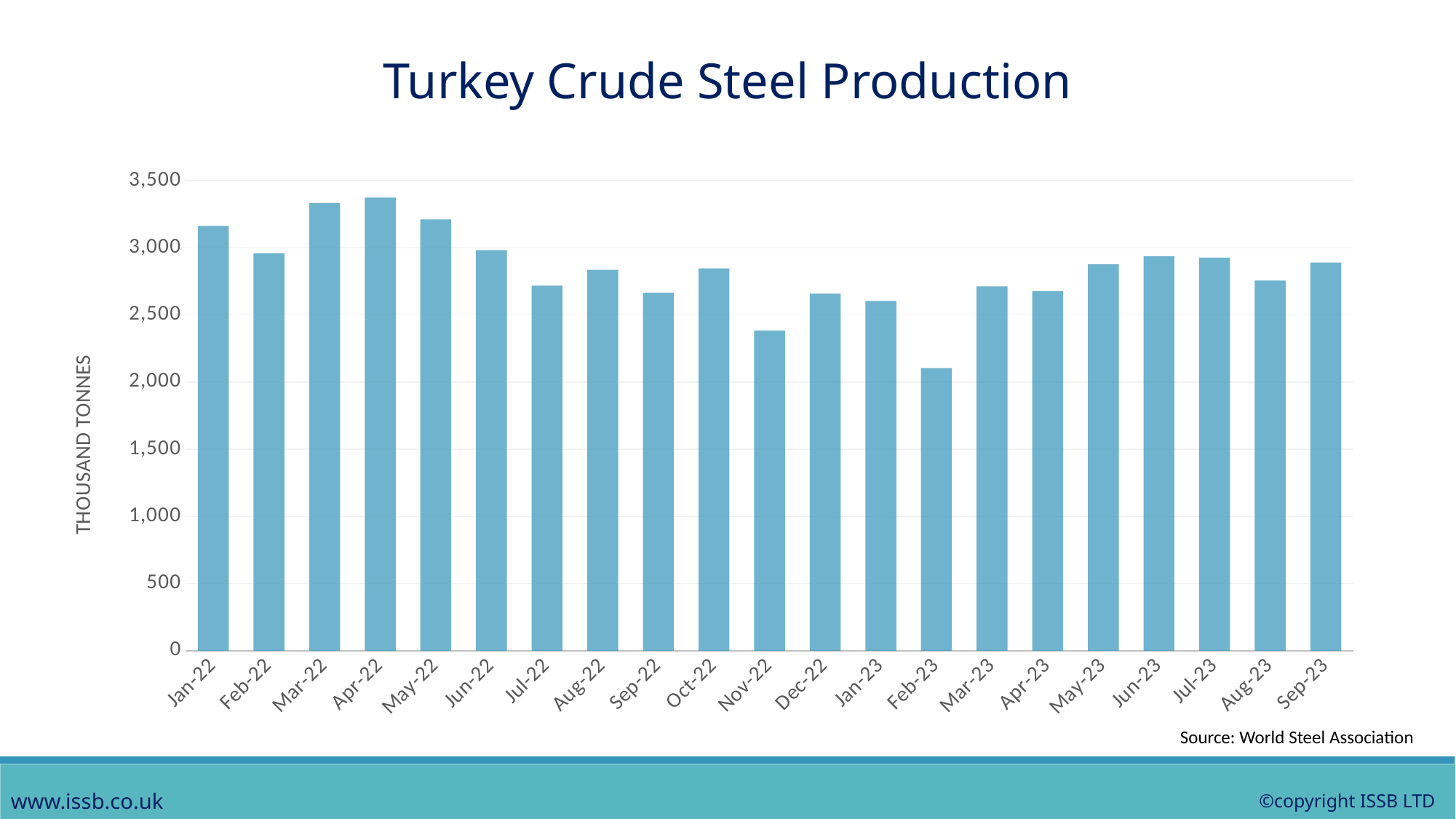
Is the value for Jan-22 greater or less than 3,000? greater What kind of chart is shown on the slide? Bar chart Is the value for Jul-22 greater or less than 2,500? greater Which month has the highest crude steel production? Apr-22 Which is larger, the value for Nov-22 or the value for Dec-22? Dec-22 What unit is shown on the vertical axis label? THOUSAND TONNES Do the values rise or fall from Apr-22 to Jul-22? fall Is the value for Feb-23 greater or less than 2,500? less Which month has the lowest crude steel production? Feb-23 How many months (bars) are plotted on the chart? 21 What is the title of the chart? Turkey Crude Steel Production